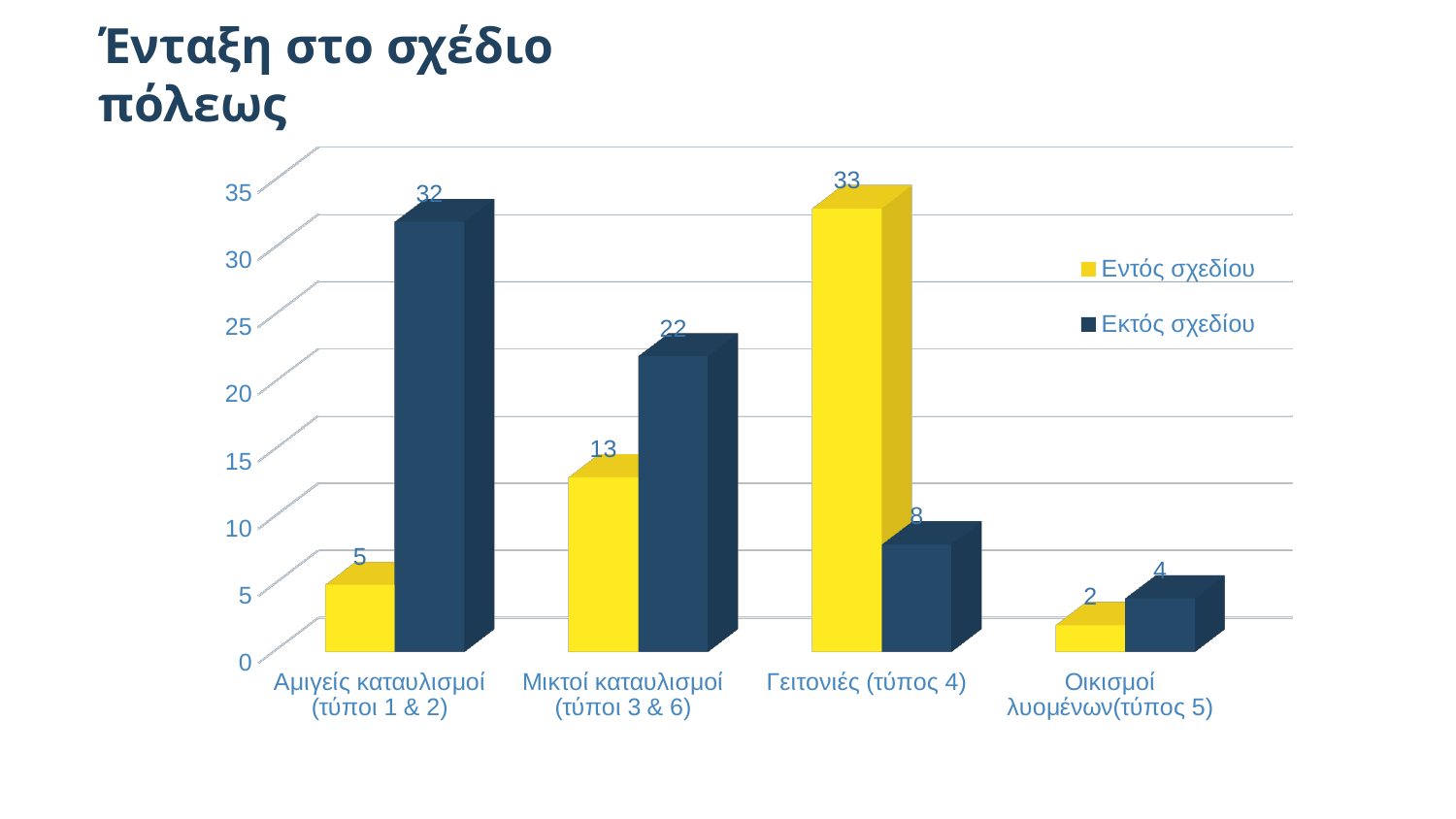
Which category has the highest Εκτός σχεδίου value? Αμιγείς καταυλισμοί (τύποι 1 & 2) What kind of chart is shown on the slide? Bar chart What is the value of Εντός σχεδίου for Αμιγείς καταυλισμοί (τύποι 1 & 2)? 5 Which category has the lowest Εντός σχεδίου value? Οικισμοί λυομένων(τύπος 5) What is the difference between Εκτός σχεδίου and Εντός σχεδίου for Αμιγείς καταυλισμοί (τύποι 1 & 2)? 27 What is the value of Εκτός σχεδίου for Μικτοί καταυλισμοί (τύποι 3 & 6)? 22 How many series does the legend list? 2 What is the value of Εντός σχεδίου for Γειτονιές (τύπος 4)? 33 What is the value of Εκτός σχεδίου for Οικισμοί λυομένων(τύπος 5)? 4 Which is larger for Γειτονιές (τύπος 4): Εντός σχεδίου or Εκτός σχεδίου? Εντός σχεδίου What is the title of the slide? Ένταξη στο σχέδιο πόλεως How many categories are shown on the x axis? 4